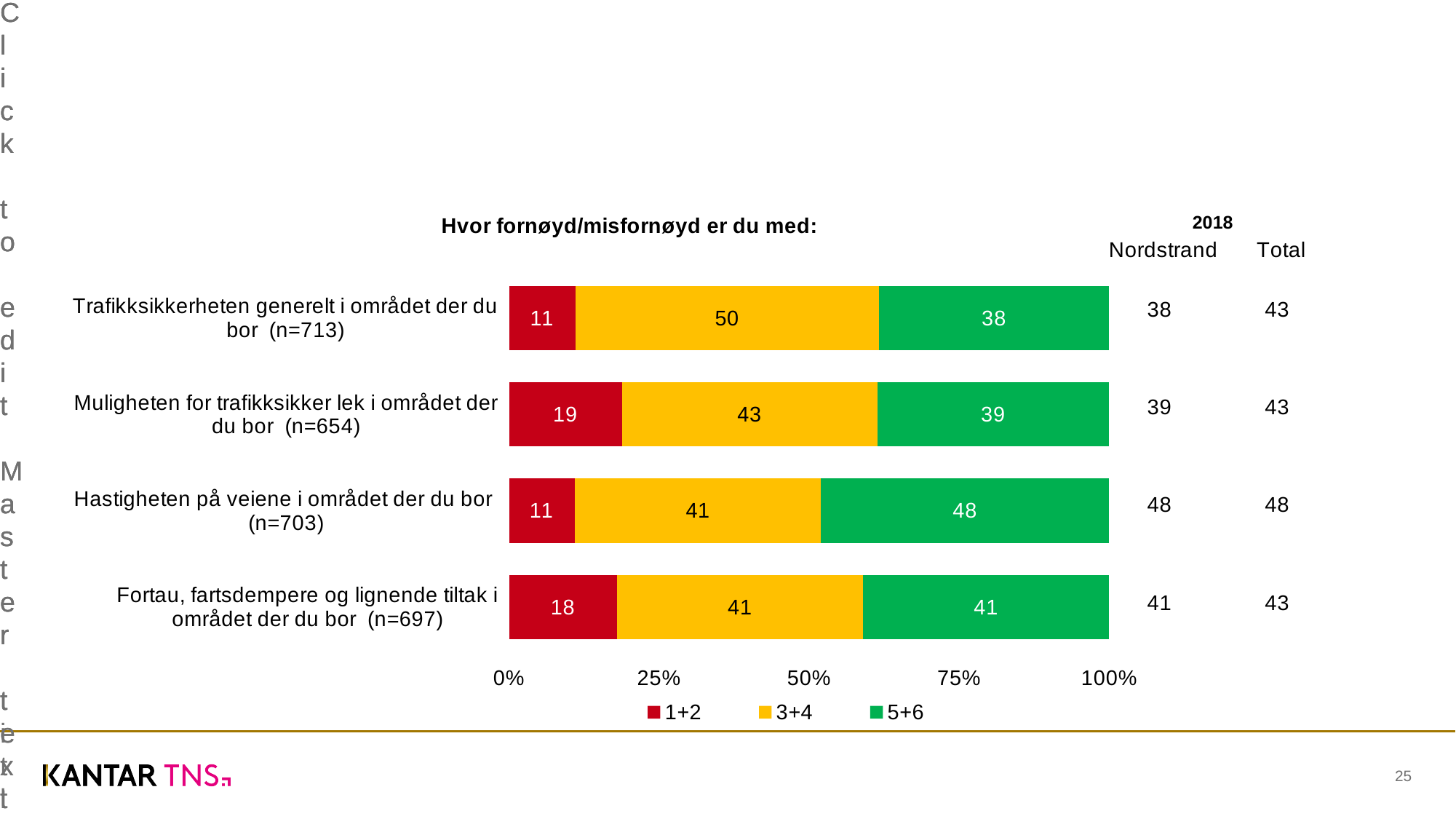
How many categories are plotted in the chart? 4 What is the total of the stacked bar for 'Muligheten for trafikksikker lek i området der du bor (n=654)'? 101 Which is larger: the 1+2 value for 'Fortau, fartsdempere og lignende tiltak i området der du bor (n=697)' or the 1+2 value for 'Hastigheten på veiene i området der du bor (n=703)'? Fortau, fartsdempere og lignende tiltak i området der du bor (n=697) Which category has the lowest 5+6 value? Trafikksikkerheten generelt i området der du bor (n=713) What colour represents the 5+6 series in the chart? Green What is the value of the 5+6 segment for 'Hastigheten på veiene i området der du bor (n=703)'? 48 What is the value of the 3+4 segment for 'Trafikksikkerheten generelt i området der du bor (n=713)'? 50 What is the value of the 1+2 segment for 'Muligheten for trafikksikker lek i området der du bor (n=654)'? 19 Which category has the highest 5+6 value? Hastigheten på veiene i området der du bor (n=703) How many series does the legend list? 3 What is the difference between the 3+4 value for 'Trafikksikkerheten generelt i området der du bor (n=713)' and the 3+4 value for 'Hastigheten på veiene i området der du bor (n=703)'? 9 What kind of chart is shown on the slide? Stacked bar chart